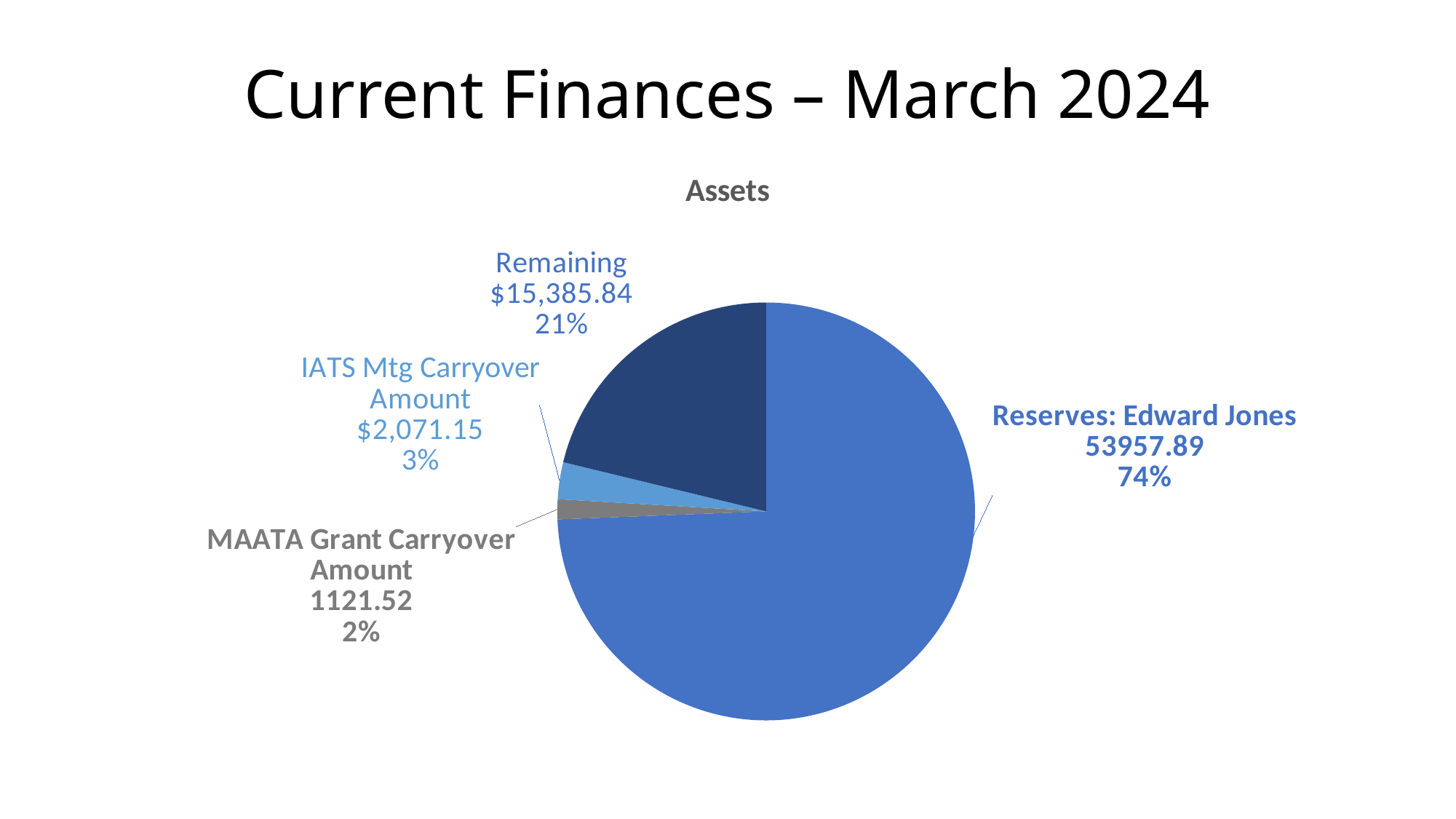
What is the value shown for Reserves: Edward Jones? 53957.89 What share of the pie does Reserves: Edward Jones represent? 74% What is the value shown for Remaining? $15,385.84 Which is larger, the IATS Mtg Carryover Amount or the MAATA Grant Carryover Amount? IATS Mtg Carryover Amount Which category has the largest slice of the pie? Reserves: Edward Jones How many slices does the pie chart have? 4 Which category has the smallest slice of the pie? MAATA Grant Carryover Amount What is the title of the chart? Assets What is the value shown for MAATA Grant Carryover Amount? 1121.52 What type of chart is shown on the slide? pie chart What is the value shown for IATS Mtg Carryover Amount? $2,071.15 What share of the pie does Remaining represent? 21%